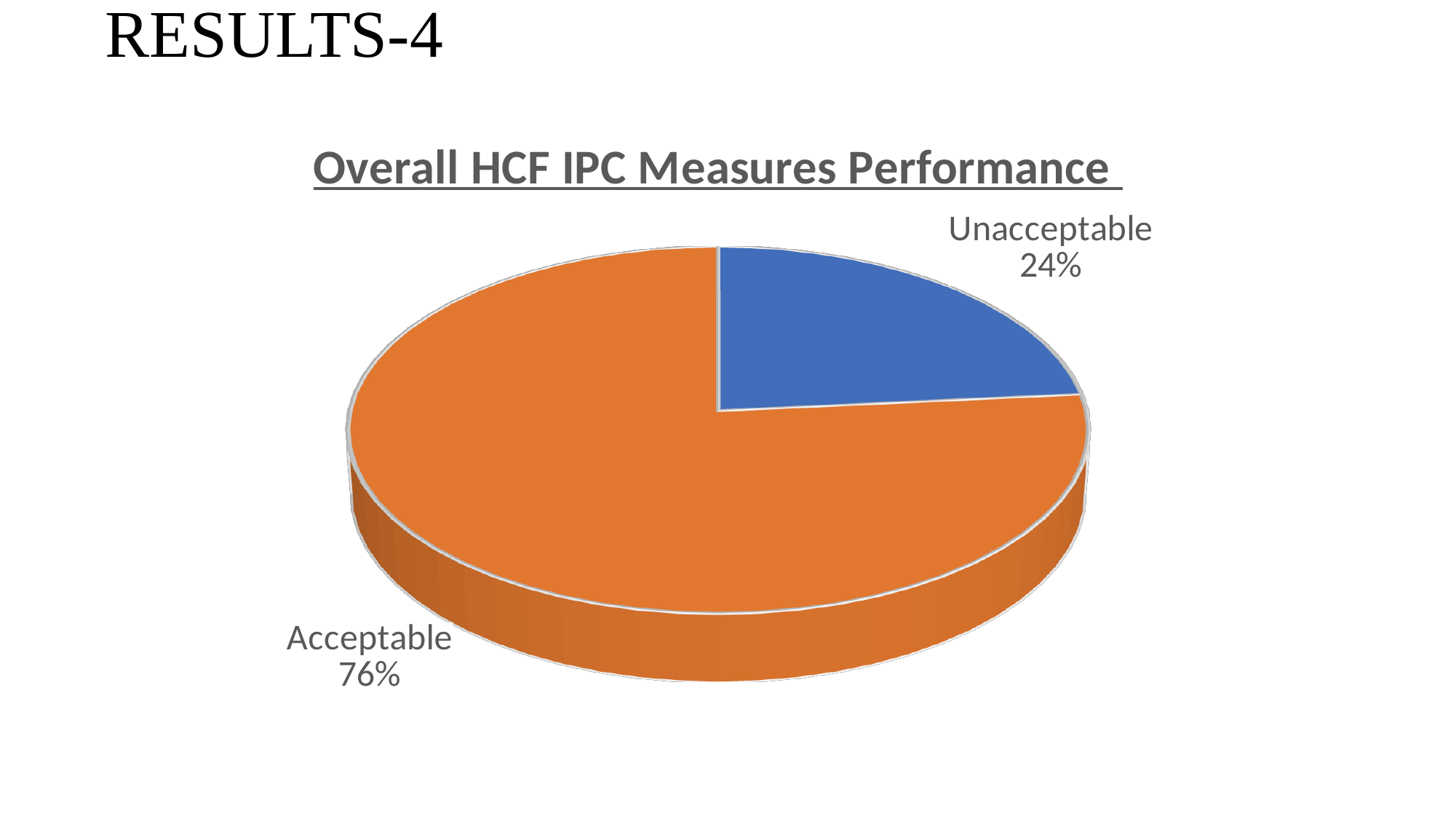
What kind of chart is shown on the slide? Pie chart Which category has the largest slice of the pie? Acceptable What is the difference in percentage points between the Acceptable and Unacceptable slices? 52 Which is larger, the Acceptable slice or the Unacceptable slice? Acceptable What colour is the Unacceptable slice? Blue How many slices does the pie chart have? 2 Which category has the smallest slice of the pie? Unacceptable What share of the pie is labelled Unacceptable? 24% What is the total of the two slice percentages shown? 100% What share of the pie is labelled Acceptable? 76% What is the title of the chart? Overall HCF IPC Measures Performance